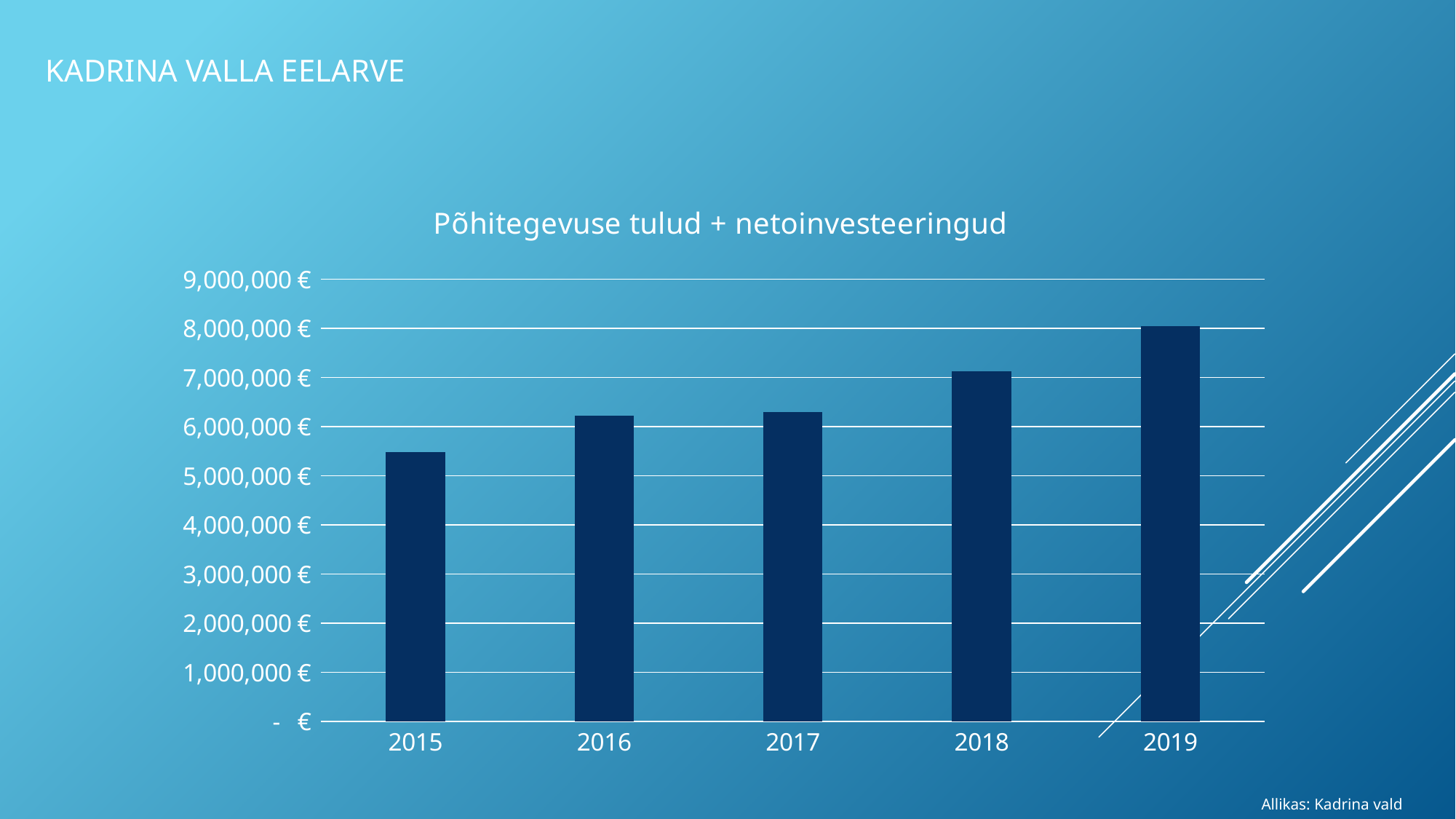
Is the value for 2015 greater or less than 5,000,000 €? greater Which year has the lowest bar in the chart? 2015 Is the value for 2018 greater or less than 7,000,000 €? greater Is the value for 2015 greater or less than 6,000,000 €? less What is the title of the chart? Põhitegevuse tulud + netoinvesteeringud Do the values generally rise or fall from 2015 to 2019? rise How many years are shown on the x axis of the chart? 5 What kind of chart is shown on the slide? bar chart What is the highest value shown on the y axis of the chart? 9,000,000 € Which year has the highest bar in the chart? 2019 Which year has the larger value, 2015 or 2018? 2018